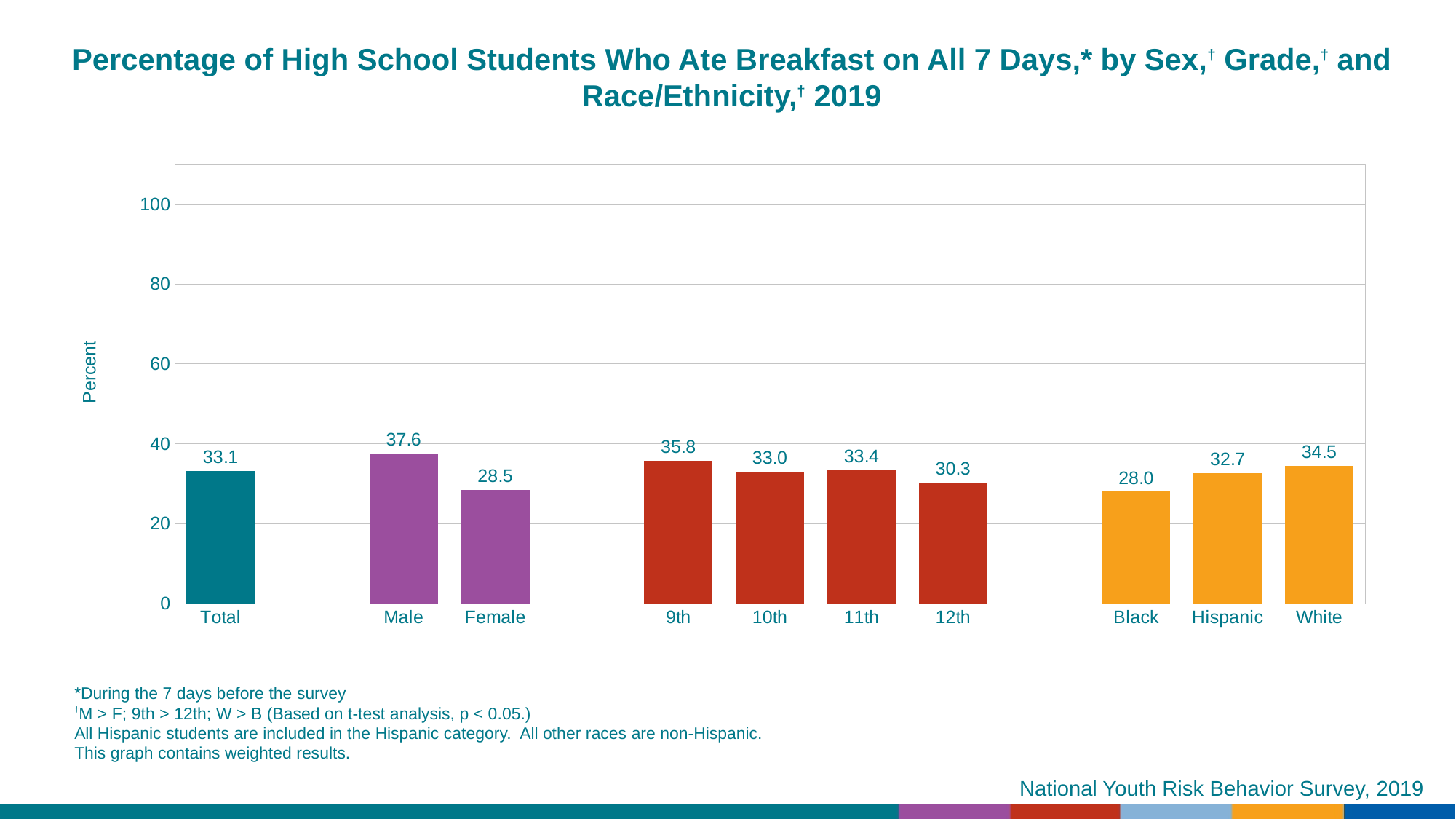
What kind of chart is shown on the slide? bar chart What is the difference between the Male and Female values? 9.1 Which category has the lowest value? Black Which category has the highest value? Male How many bars are shown in the chart? 10 What percentage of male students ate breakfast on all 7 days? 37.6 What is the difference between the White and Black values? 6.5 Which is larger, the value for 9th grade or the value for 12th grade? 9th What is the value for Total? 33.1 What is the value for 12th grade? 30.3 What is the value for Hispanic students? 32.7 Is the value for Female greater or less than 40? less